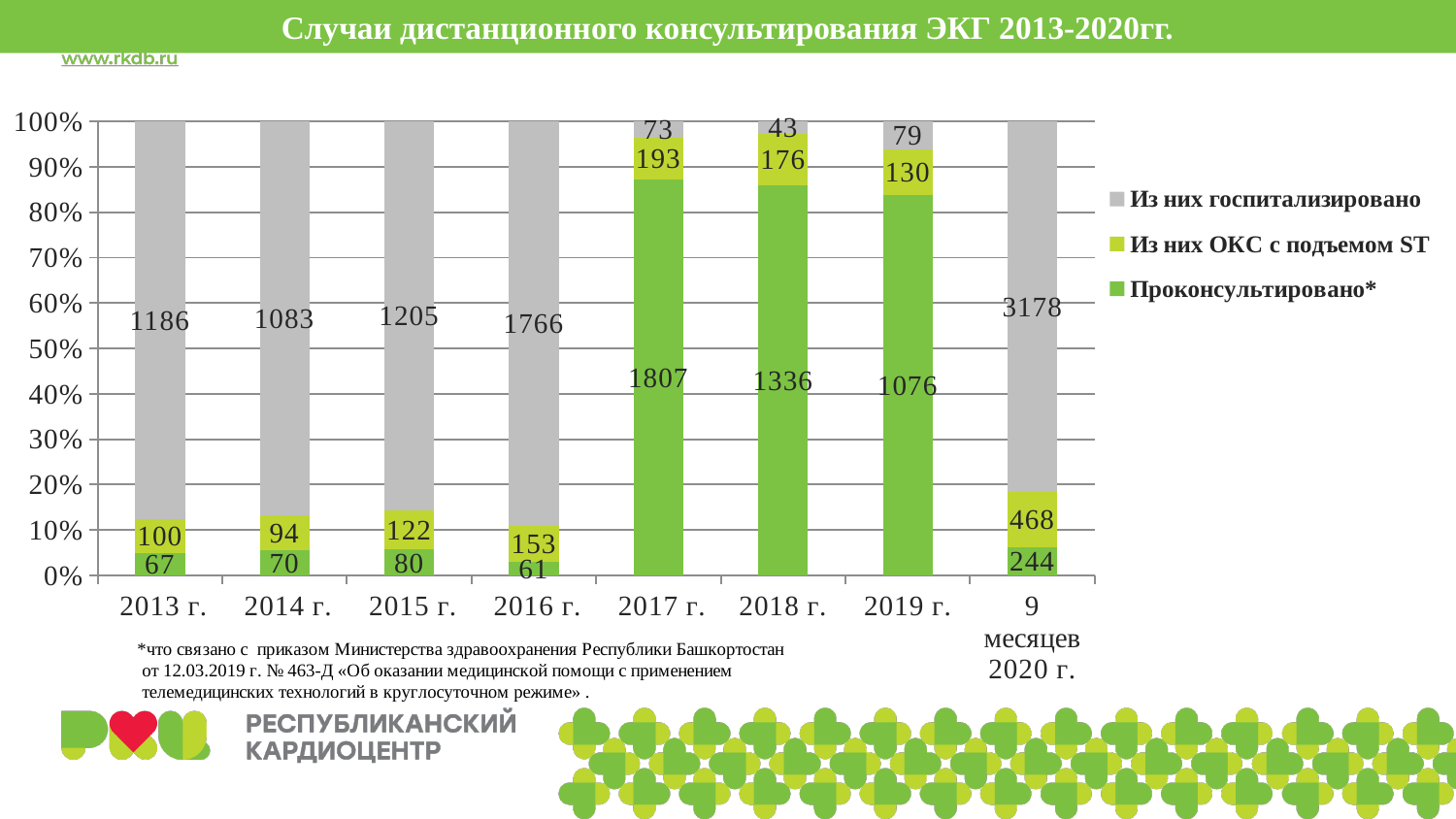
What is the value labelled on the 'Из них ОКС с подъемом ST' segment for 9 месяцев 2020 г.? 468 What is the value labelled on the 'Из них госпитализировано' segment for 2018 г.? 43 Which is larger: the 'Проконсультировано*' value for 2018 г. or for 2019 г.? 2018 г. What is the value labelled on the grey 'Из них госпитализировано' segment for 2013 г.? 1186 How many categories are shown on the x axis? 8 Which category has the lowest labelled value for the 'Проконсультировано*' series? 2016 г. How many series does the legend list? 3 What is the title of the chart? Случаи дистанционного консультирования ЭКГ 2013-2020гг. What is the difference between the 'Из них ОКС с подъемом ST' values for 2017 г. and 2018 г.? 17 What is the value labelled on the green 'Проконсультировано*' segment for 2017 г.? 1807 Which category has the highest labelled value for the 'Из них госпитализировано' series? 9 месяцев 2020 г. What kind of chart is shown on the slide? Stacked bar chart